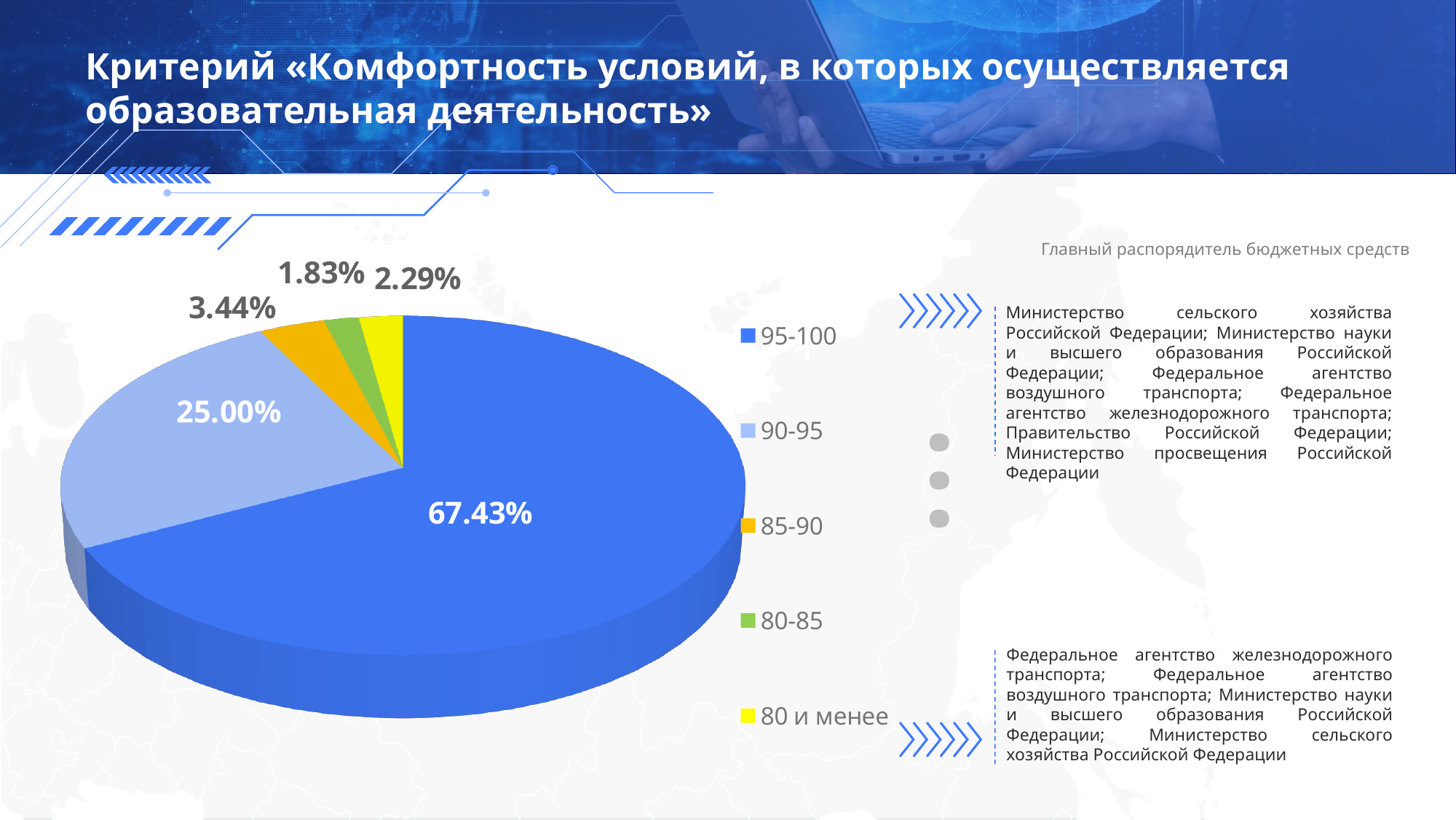
Which category has the smallest slice of the pie? 80-85 What is the value shown for the 90-95 category? 25.00% What is the value shown for the 85-90 category? 3.44% What is the value shown for the 80-85 category? 1.83% Which category has the largest slice of the pie? 95-100 What kind of chart is shown on the slide? pie chart What share of the pie does the 95-100 category have? 67.43% How many categories does the pie chart have? 5 What is the value shown for the '80 и менее' category? 2.29% What is the difference between the 95-100 and 90-95 shares? 42.43% What colour is the slice for the 90-95 category? light blue Which is larger, the share for 85-90 or the share for '80 и менее'? 85-90